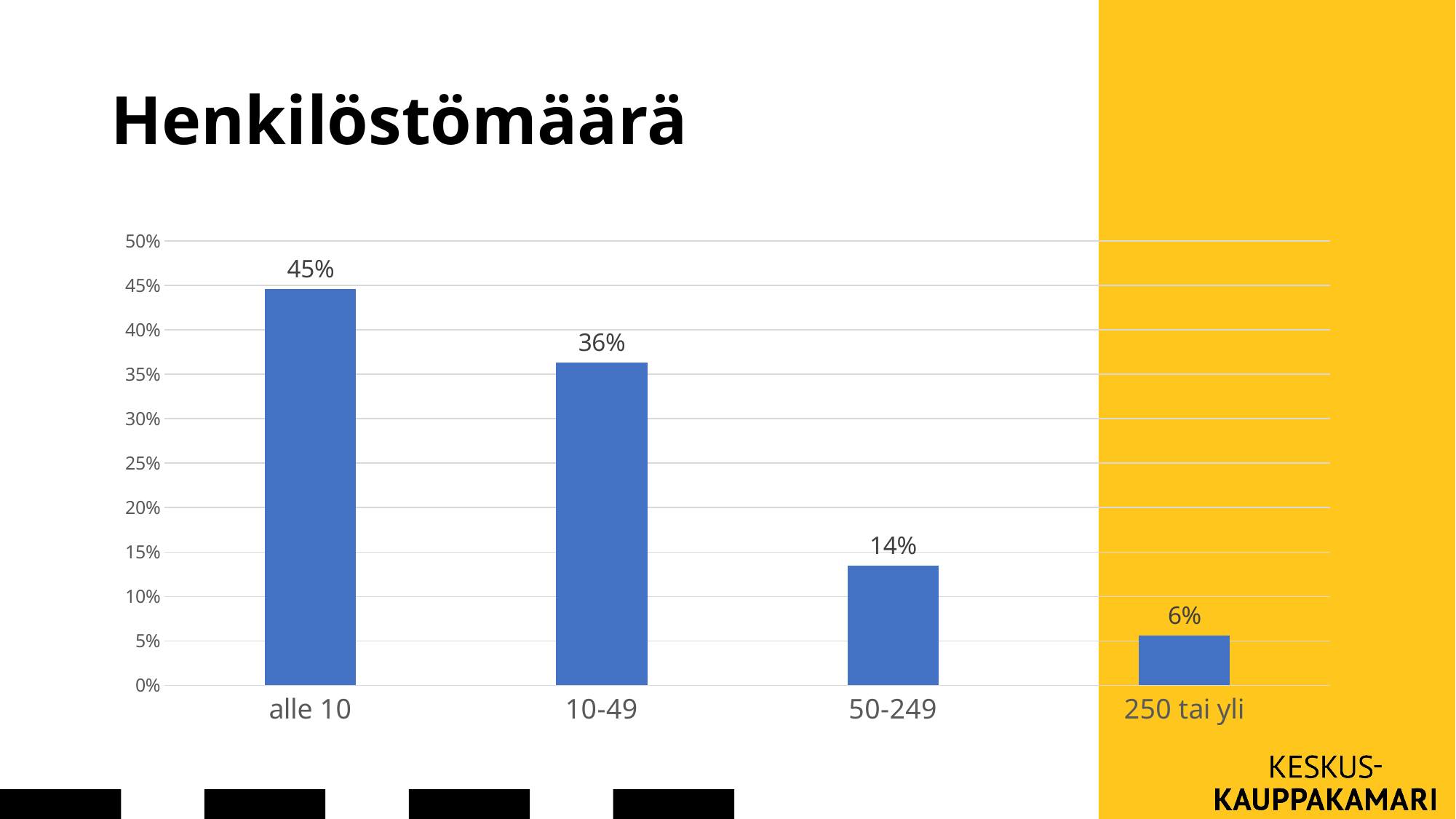
Which category has the lowest value? 250 tai yli What is the value for the '250 tai yli' category? 6% What is the difference between the values for '50-249' and '250 tai yli'? 8% What kind of chart is shown on the slide? bar chart Which is larger, the value for '10-49' or the value for '50-249'? 10-49 What is the value for the 'alle 10' category? 45% What is the difference between the values for 'alle 10' and '10-49'? 9% How many categories are shown on the x axis? 4 Do the values rise or fall from left to right along the x axis? fall Which category has the highest value? alle 10 What is the value for the '10-49' category? 36% What is the value for the '50-249' category? 14%